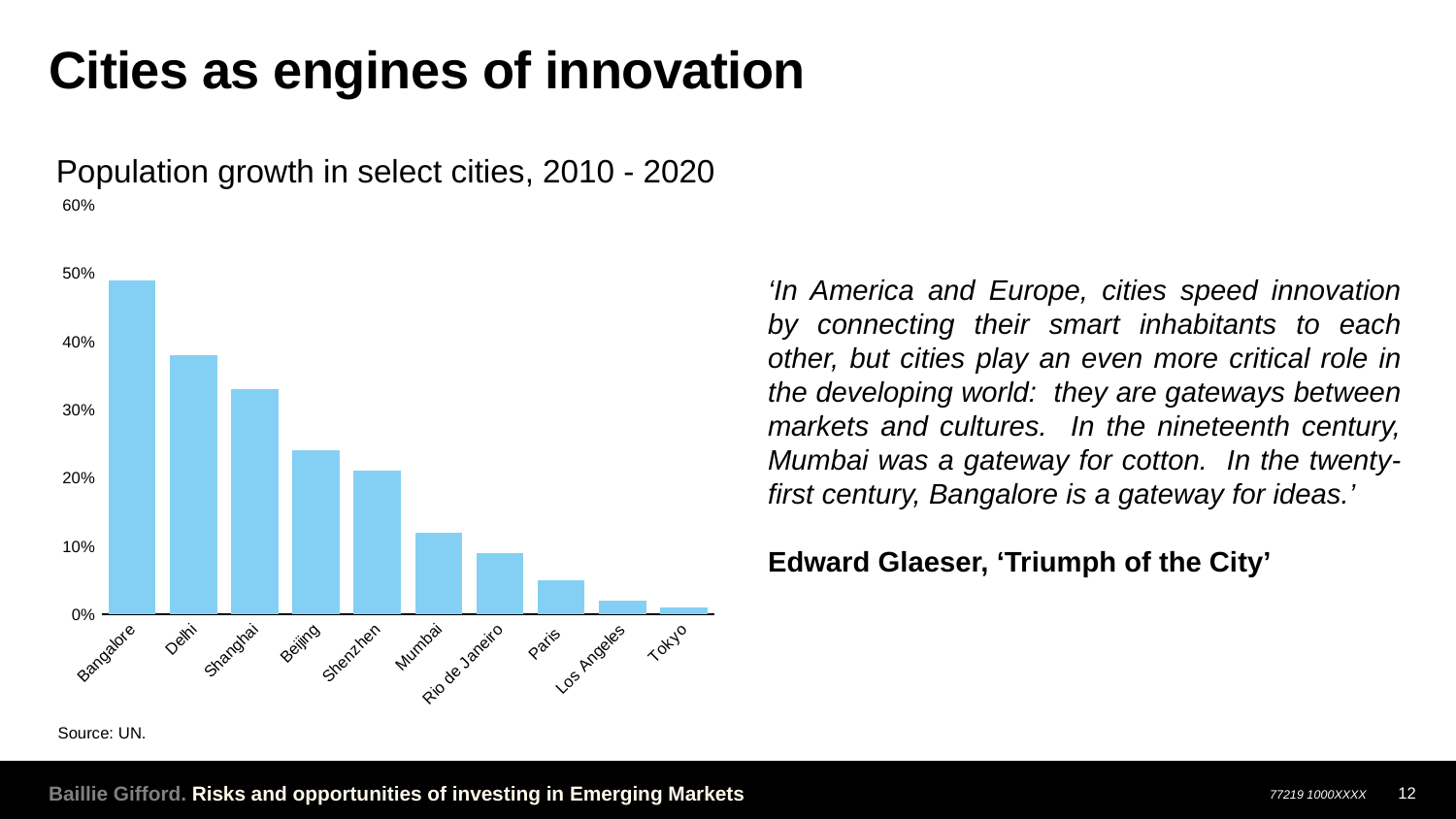
Do the values rise or fall moving from left to right along the x axis? fall Which city has the highest population growth in the chart? Bangalore Is the value for Bangalore greater or less than 40%? greater Which has the larger population growth, Shanghai or Shenzhen? Shanghai Is the value for Mumbai greater or less than 10%? greater Which city has the lowest population growth in the chart? Tokyo Is the value for Paris greater or less than 10%? less What kind of chart is shown on the slide? bar chart How many cities are shown in the chart? 10 What is the title of the chart? Population growth in select cities, 2010 - 2020